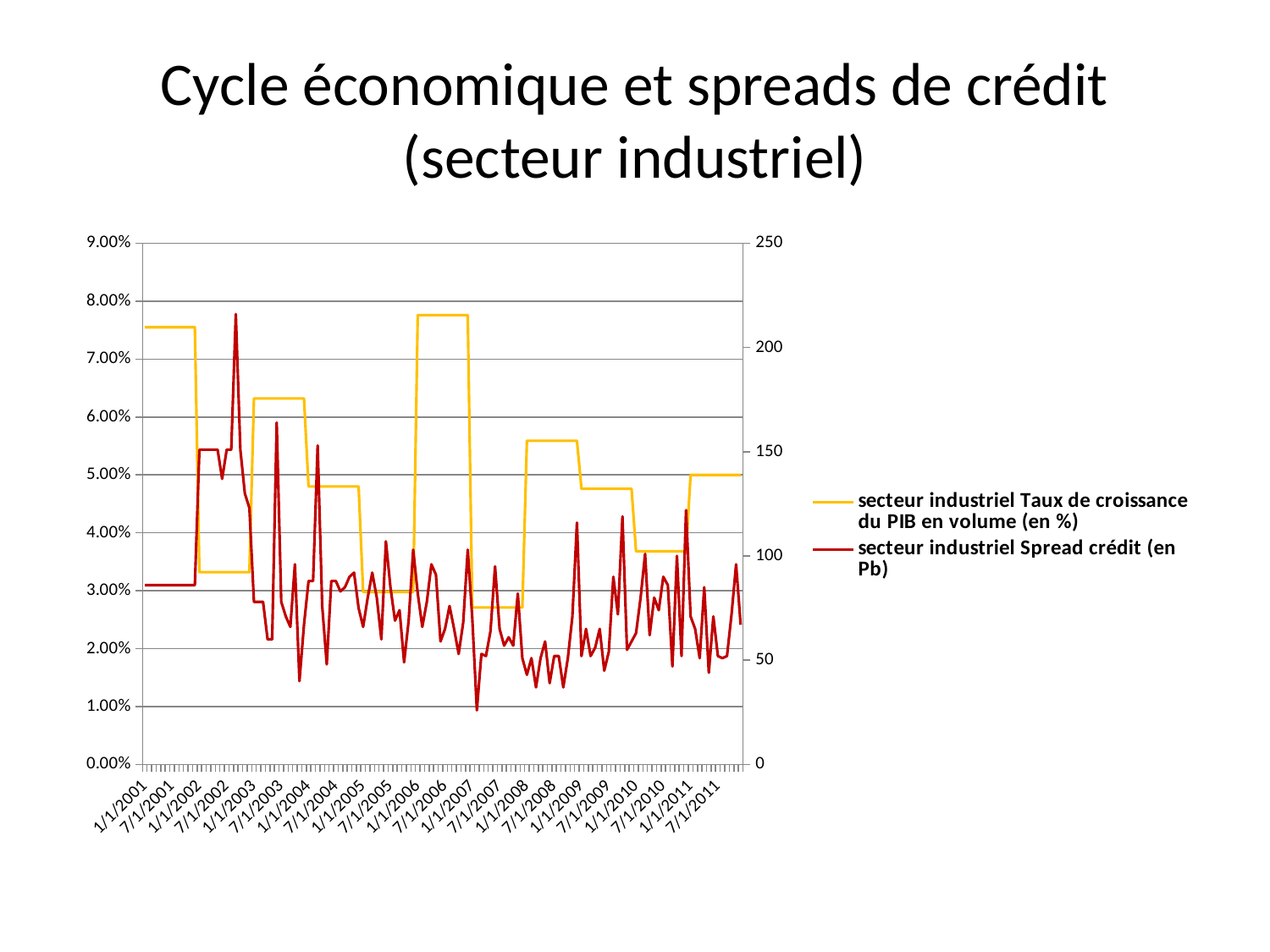
Which colour is used for the 'secteur industriel Spread crédit (en Pb)' series? red What is the title of the slide's chart? Cycle économique et spreads de crédit (secteur industriel) Is the lowest value of 'secteur industriel Spread crédit (en Pb)' around 1/1/2007 greater or less than 50? less How many date labels are shown on the x axis? 22 Is the value of 'secteur industriel Taux de croissance du PIB en volume (en %)' at 7/1/2006 greater or less than 7.00%? greater Is the value of 'secteur industriel Taux de croissance du PIB en volume (en %)' at 7/1/2007 greater or less than 4.00%? less How many series does the legend list? 2 What kind of chart is shown on the slide? line chart Does the 'secteur industriel Taux de croissance du PIB en volume (en %)' series end higher or lower at 7/1/2011 than it started at 1/1/2001? lower